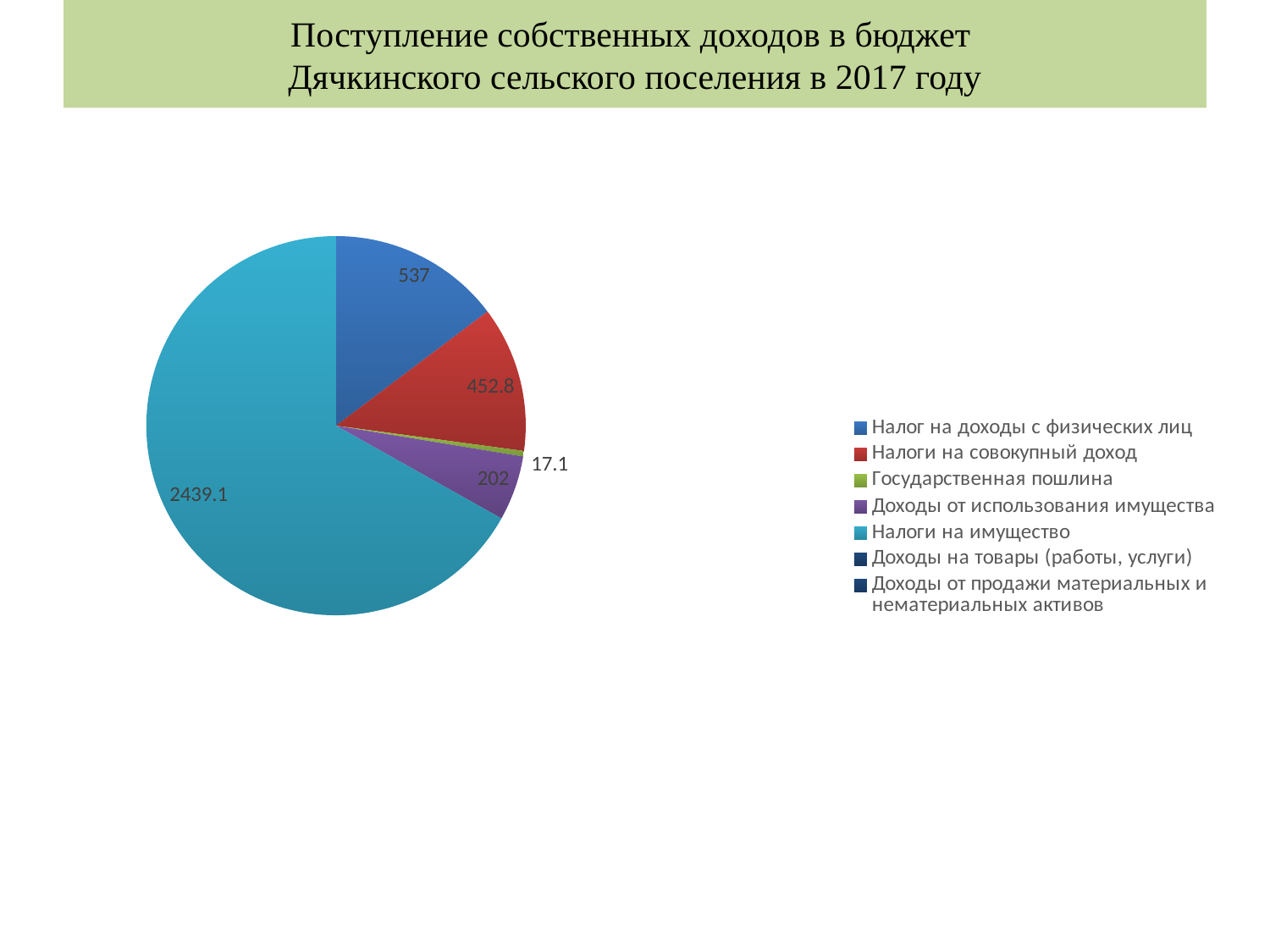
What kind of chart is shown on the slide? Pie chart Which category has the largest slice of the pie? Налоги на имущество What value is shown for Государственная пошлина? 17.1 What is the difference between the values for Налог на доходы с физических лиц and Налоги на совокупный доход? 84.2 What value is shown for Налоги на имущество? 2439.1 Which is larger: Доходы от использования имущества or Налоги на совокупный доход? Налоги на совокупный доход Of the slices with data labels, which category has the smallest value? Государственная пошлина What value is shown for Доходы от использования имущества? 202 What value is shown for Налоги на совокупный доход? 452.8 What value is shown for Налог на доходы с физических лиц? 537 How many entries does the legend list? 7 What is the difference between the values for Налоги на имущество and Налог на доходы с физических лиц? 1902.1